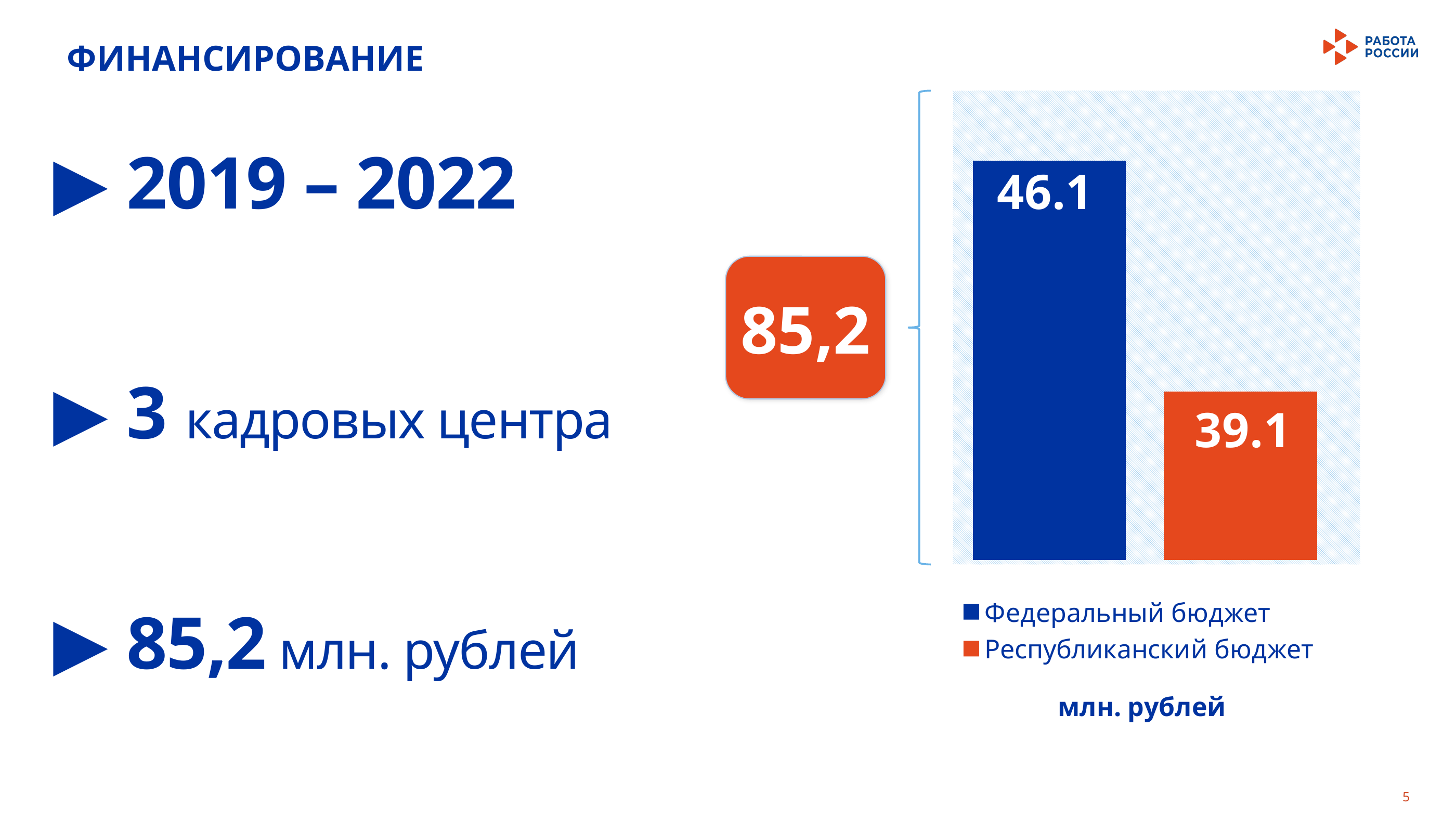
Which budget has the lower value in the chart? Республиканский бюджет What value is shown for Республиканский бюджет in the chart? 39.1 What is the difference between the Федеральный бюджет and Республиканский бюджет values? 7.0 What is the total of the two bar values in the chart? 85.2 What value is shown for Федеральный бюджет in the chart? 46.1 What unit is given below the chart legend? млн. рублей How many entries does the chart legend list? 2 What kind of chart is shown on the slide? bar chart What colour is the bar for Республиканский бюджет? orange Is the value for Федеральный бюджет larger or smaller than the value for Республиканский бюджет? larger Which budget has the higher value in the chart? Федеральный бюджет How many bars are plotted in the chart? 2